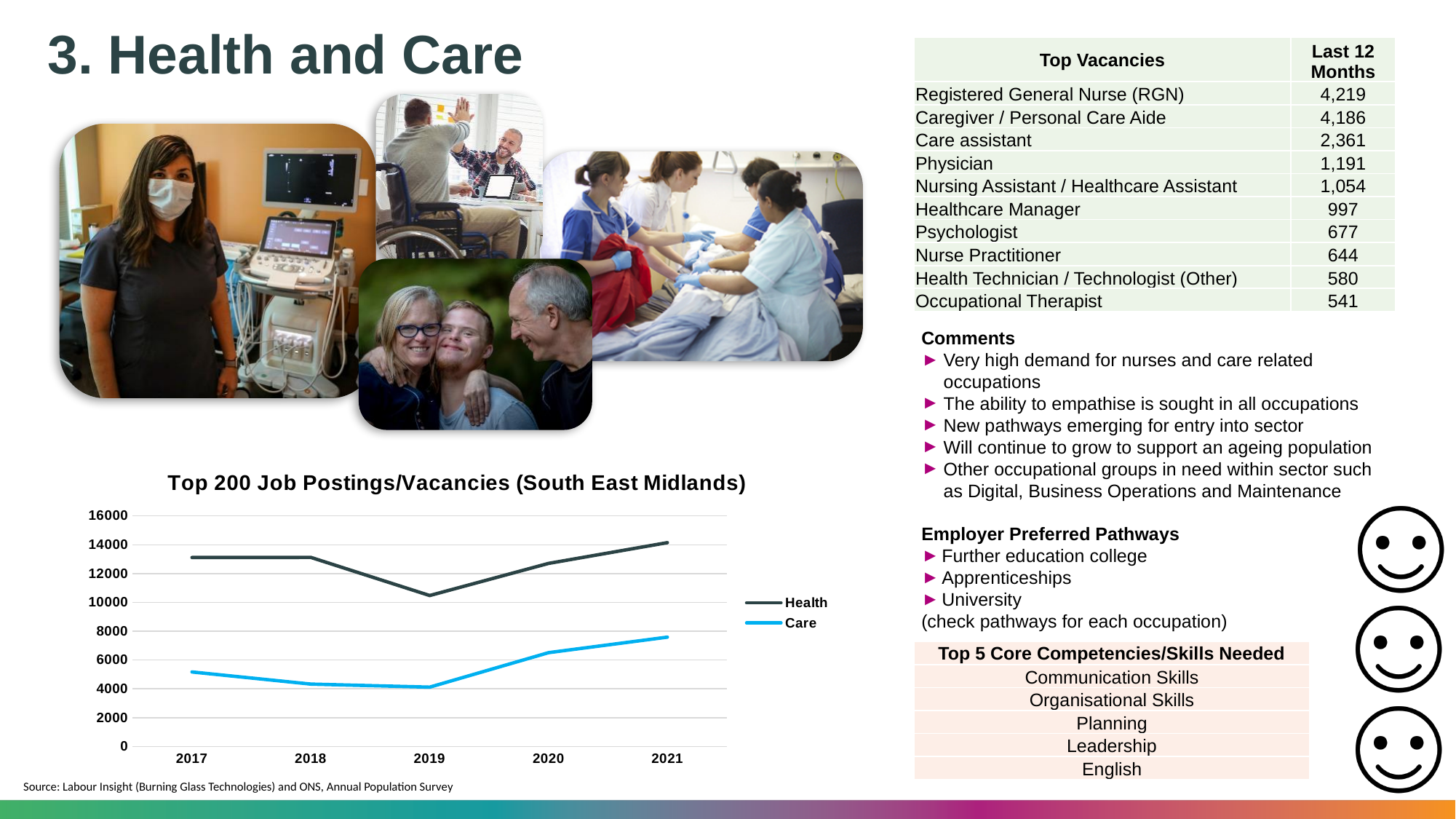
How many series does the legend of the chart list? 2 Is the value for Health in 2019 greater or less than 12000? less What is the title of the chart? Top 200 Job Postings/Vacancies (South East Midlands) Does the Care series rise or fall between 2019 and 2021? rise In which year is the Care series at its highest? 2021 Is the value for Care in 2021 greater or less than 6000? greater What kind of chart is shown on the slide? line chart Which series is shown in light blue in the chart? Care In which year is the Health series at its highest? 2021 In which year is the Health series at its lowest? 2019 Which series has the larger value in 2020, Health or Care? Health How many years are plotted along the x axis of the chart? 5